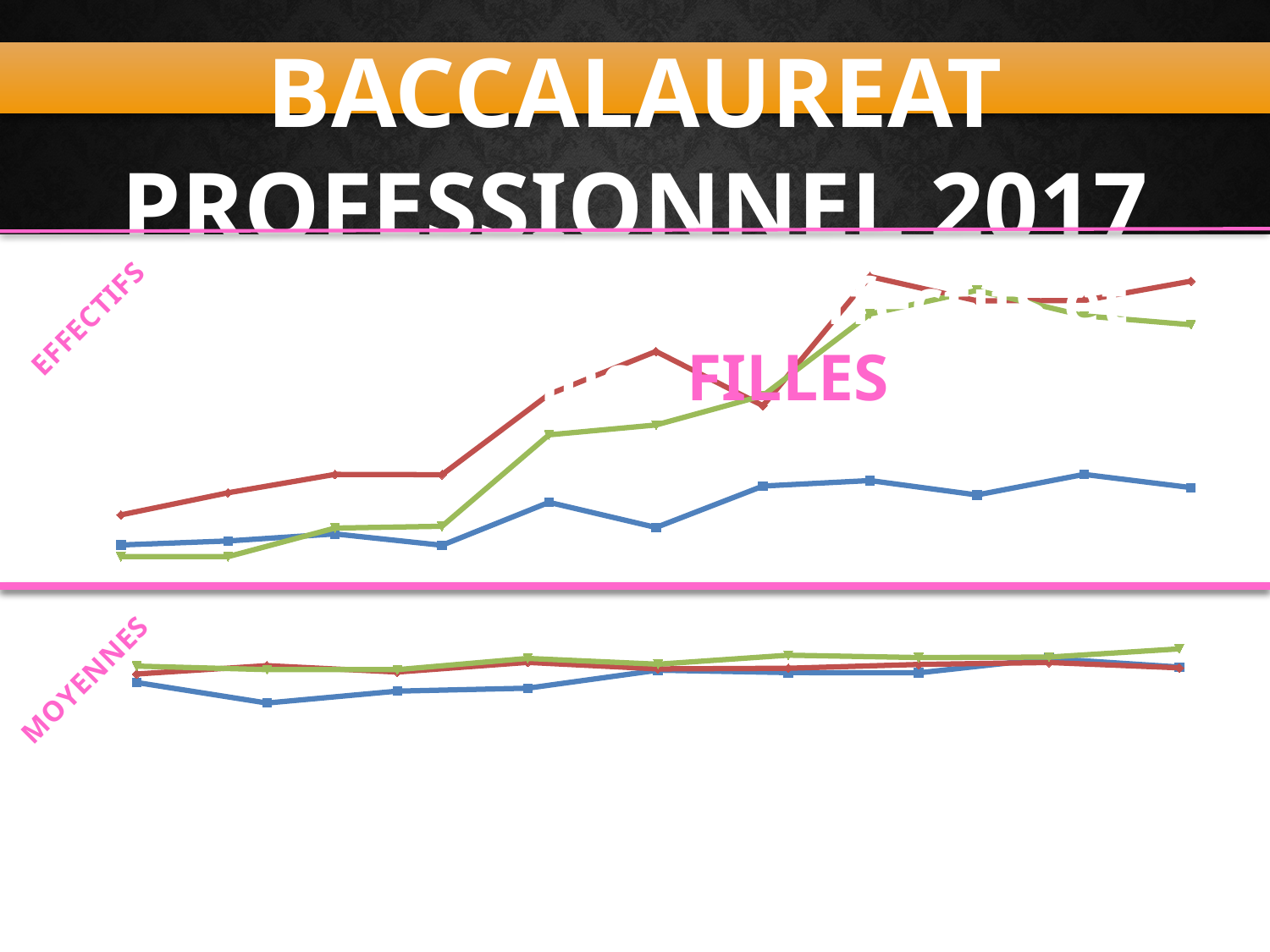
In the top chart labelled EFFECTIFS, which coloured line is lowest at the rightmost point? blue In the top chart labelled EFFECTIFS, which coloured line is highest at the rightmost point? red What kind of chart is the bottom chart labelled MOYENNES? line chart What is the label written beside the bottom chart? MOYENNES In the top chart labelled EFFECTIFS, do the values of the red line generally rise or fall from left to right? rise How many lines are plotted in the bottom chart labelled MOYENNES? 3 How many data points does each line in the top chart labelled EFFECTIFS have? 11 How many lines are plotted in the top chart labelled EFFECTIFS? 3 What kind of chart is the top chart labelled EFFECTIFS? line chart In the top chart labelled EFFECTIFS, do the values of the green line generally rise or fall from left to right? rise What word is written in large pink letters over the top chart? FILLES